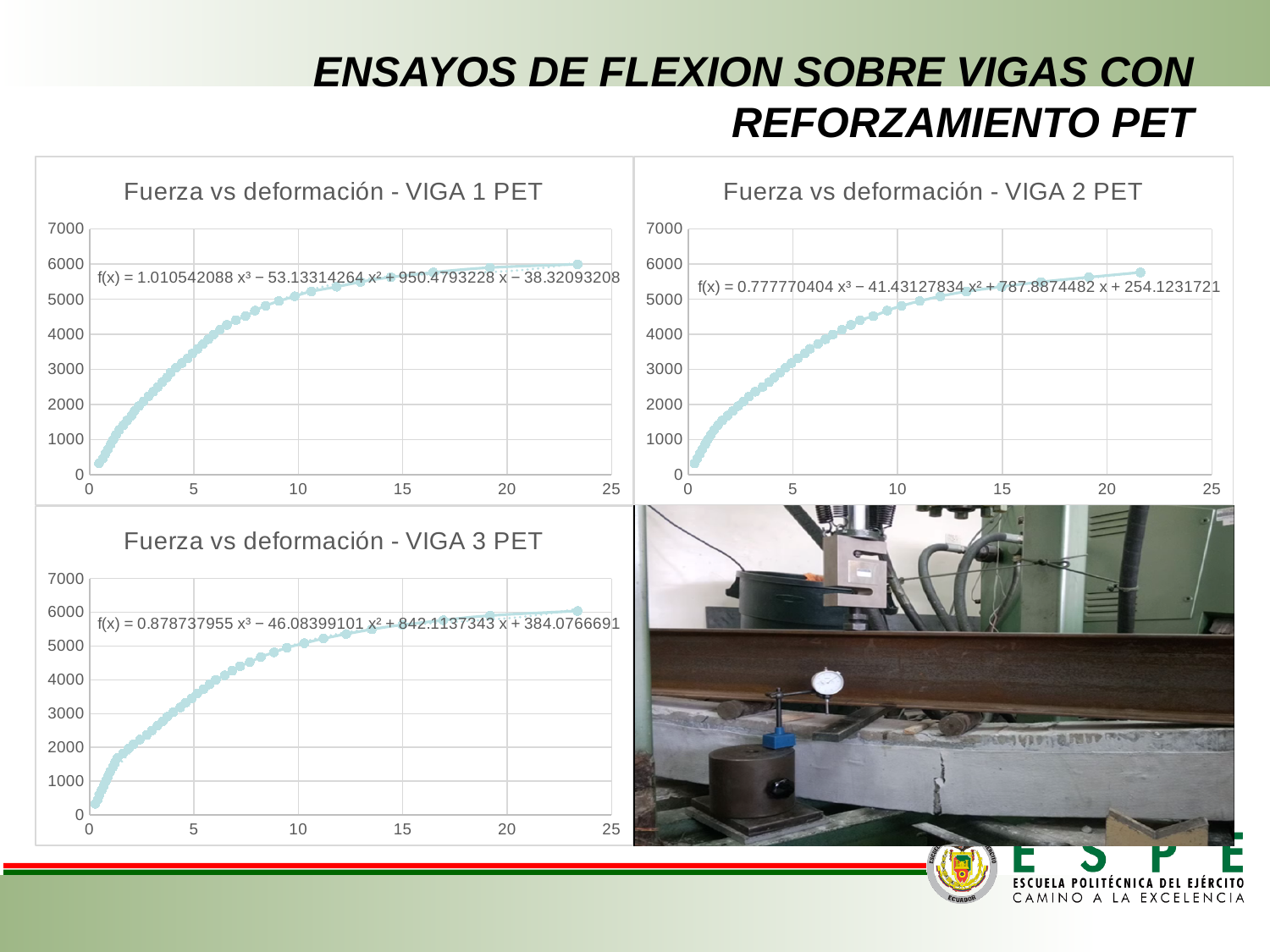
In the chart 'Fuerza vs deformación - VIGA 2 PET', is the highest plotted value greater or less than 5000? greater In the chart 'Fuerza vs deformación - VIGA 1 PET', is the value at x = 5 greater or less than 3000? greater What is the title of the chart in the top-right of the slide? Fuerza vs deformación - VIGA 2 PET In the chart 'Fuerza vs deformación - VIGA 2 PET', do the values rise or fall as the x axis increases? rise In the chart 'Fuerza vs deformación - VIGA 2 PET', is the value at x = 5 greater or less than 4000? less How many 'Fuerza vs deformación' charts are shown on the slide? 3 In the chart 'Fuerza vs deformación - VIGA 3 PET', do the values rise or fall along the x axis? rise What kind of chart is 'Fuerza vs deformación - VIGA 1 PET'? scatter chart What is the maximum value shown on the y axis of the chart 'Fuerza vs deformación - VIGA 3 PET'? 7000